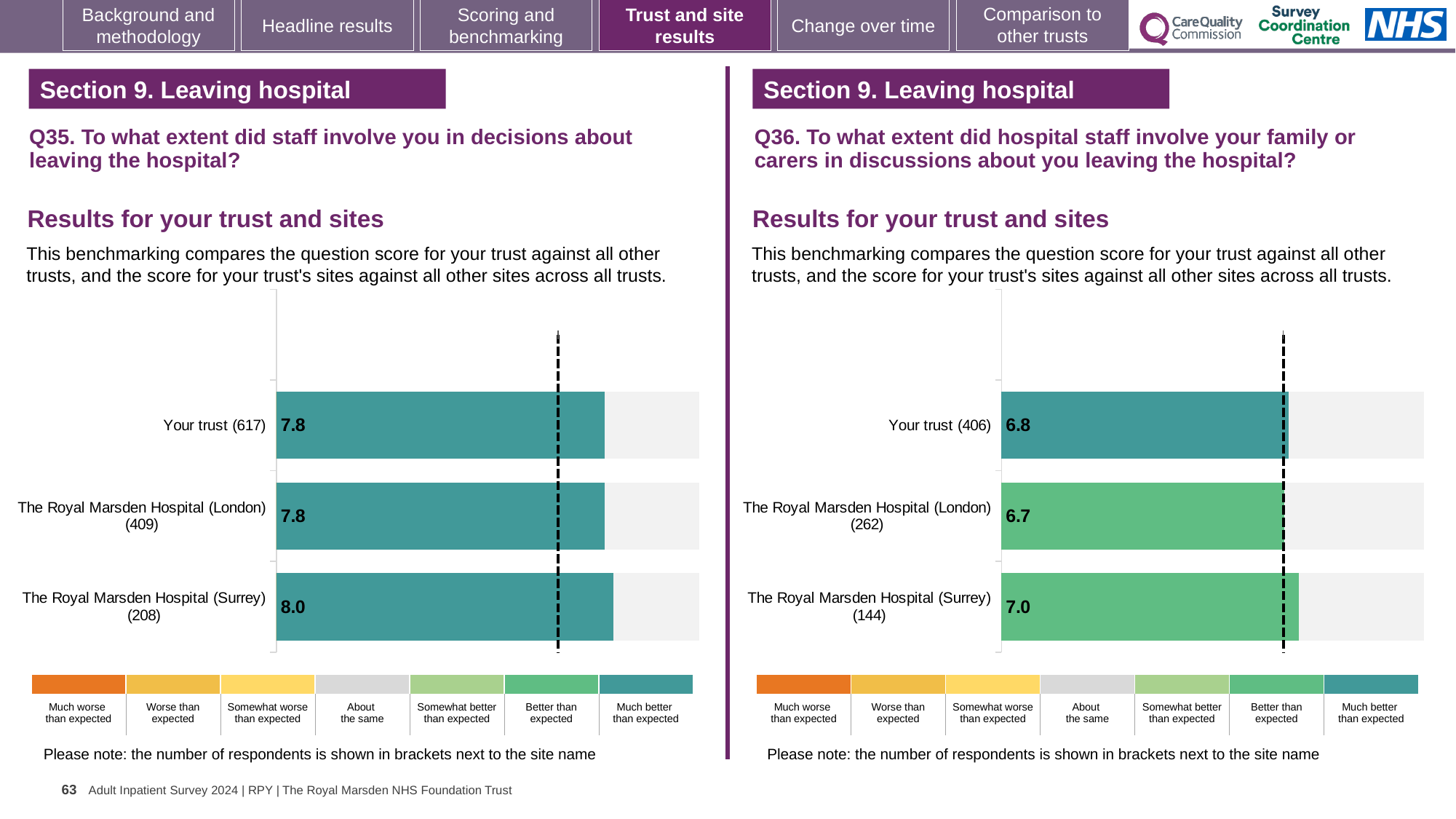
On the Q36 chart (right), what is the score for The Royal Marsden Hospital (London)? 6.7 What kind of chart is used on the Q36 chart (right)? Bar chart On the Q36 chart (right), what is the score for Your trust? 6.8 On the Q35 chart (left), what is the score for Your trust? 7.8 On the Q36 chart (right), which has the larger score: Your trust or The Royal Marsden Hospital (Surrey)? The Royal Marsden Hospital (Surrey) On the Q36 chart (right), which site or trust has the lowest score? The Royal Marsden Hospital (London) On the Q36 chart (right), how many respondents are shown in brackets for The Royal Marsden Hospital (Surrey)? 144 On the Q35 chart (left), which site or trust has the highest score? The Royal Marsden Hospital (Surrey) On the Q35 chart (left), what is the score for The Royal Marsden Hospital (Surrey)? 8.0 On the Q35 chart (left), what is the difference between the scores for The Royal Marsden Hospital (Surrey) and Your trust? 0.2 How many bars are plotted on the Q35 chart (left)? 3 On the Q36 chart (right), what is the difference between the scores for The Royal Marsden Hospital (Surrey) and The Royal Marsden Hospital (London)? 0.3